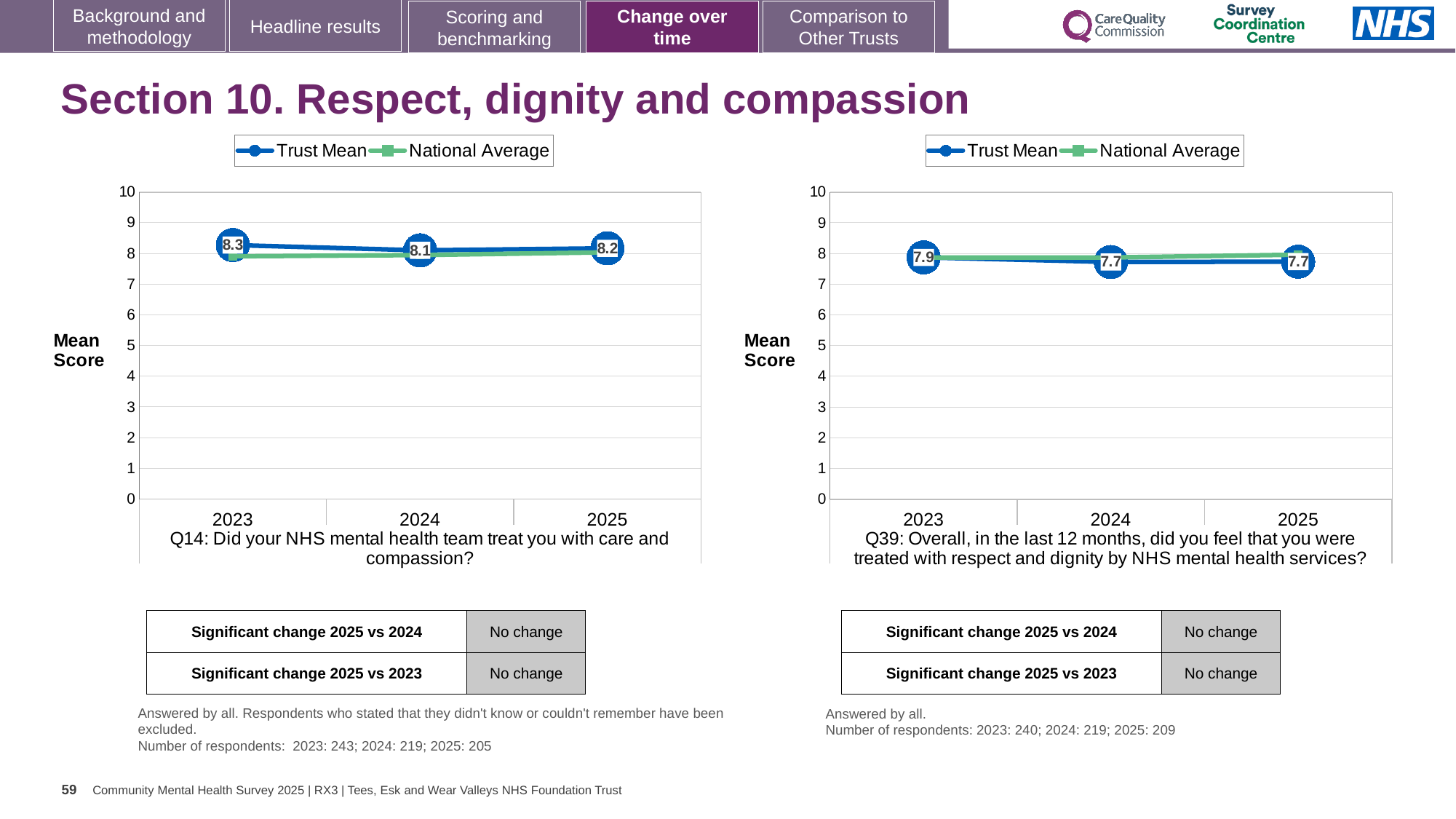
On the left chart (Q14), what is the Trust Mean for 2025? 8.2 What kind of chart is the right chart (Q39)? line chart Is the Trust Mean for 2023 on the left chart (Q14) larger or smaller than the Trust Mean for 2023 on the right chart (Q39)? larger On the right chart (Q39), what is the Trust Mean for 2024? 7.7 How many series does the legend of the left chart (Q14) list? 2 On the left chart (Q14), what is the difference between the Trust Mean in 2023 and in 2024? 0.2 On the left chart (Q14), what is the Trust Mean for 2023? 8.3 On the right chart (Q39), which year has the highest Trust Mean? 2023 On the right chart (Q39), what is the difference between the Trust Mean in 2023 and in 2025? 0.2 On the left chart (Q14), which year has the lowest Trust Mean? 2024 On the left chart (Q14), which year has the highest Trust Mean? 2023 On the right chart (Q39), what is the Trust Mean for 2023? 7.9